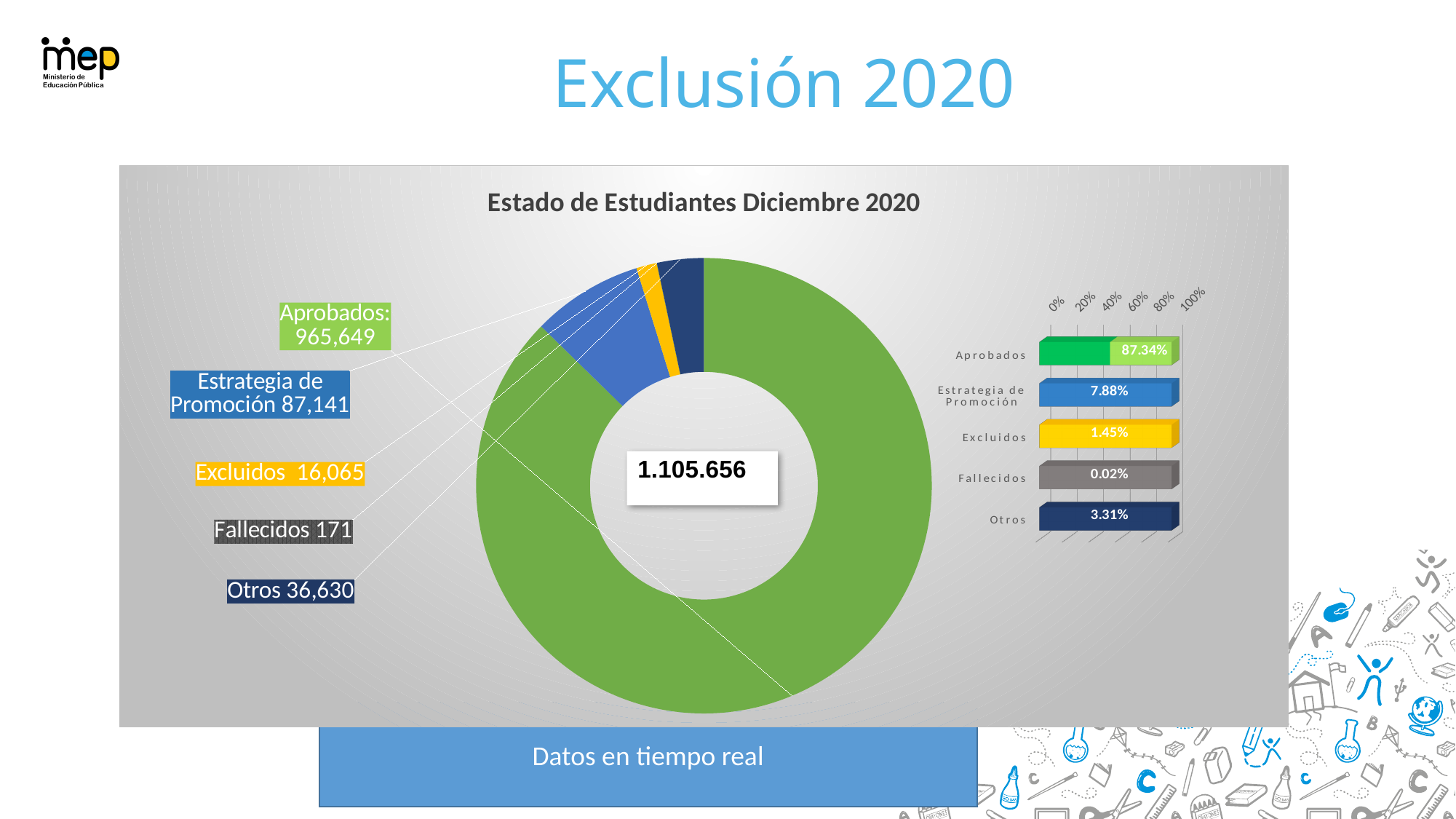
In the bar chart on the right, what percentage is shown for Aprobados? 87.34% In the donut chart, what is the value for Estrategia de Promoción? 87,141 In the donut chart, what is the difference between Otros and Excluidos? 20,565 In the donut chart, what is the value for Fallecidos? 171 In the bar chart on the right, what percentage is shown for Otros? 3.31% How many categories does the bar chart on the right show? 5 In the bar chart on the right, which is larger, Estrategia de Promoción or Excluidos? Estrategia de Promoción What is the title of the donut chart? Estado de Estudiantes Diciembre 2020 In the donut chart, what total is shown in the centre? 1.105.656 In the donut chart, what is the value for Excluidos? 16,065 In the donut chart, which category has the smallest value? Fallecidos In the donut chart, what is the value for Aprobados? 965,649